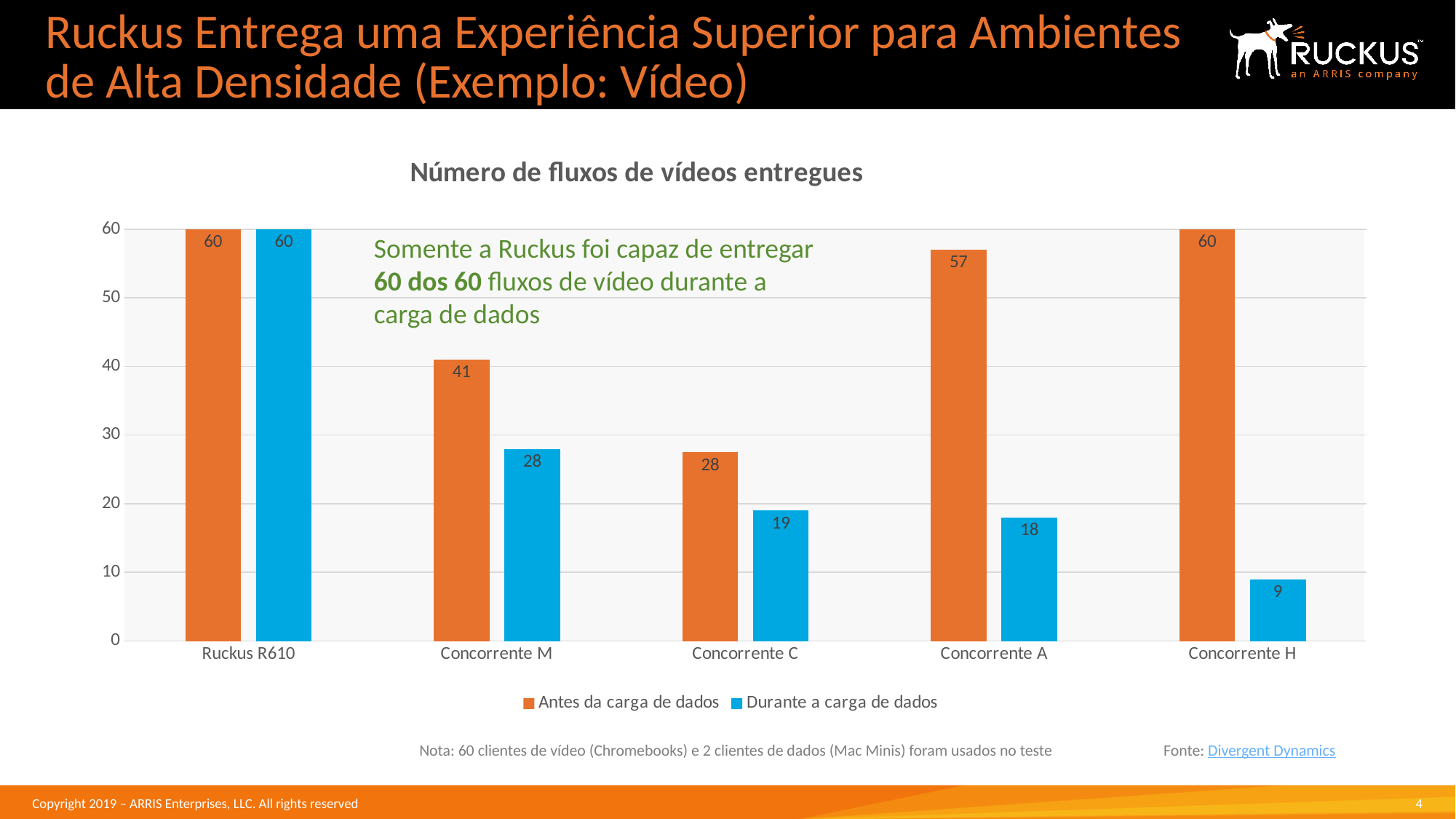
What is the title of the chart? Número de fluxos de vídeos entregues What is the value for Concorrente M in the 'Antes da carga de dados' series? 41 How many categories are shown on the x axis? 5 How many series does the legend list? 2 What is the difference between the 'Antes da carga de dados' and 'Durante a carga de dados' values for Concorrente H? 51 What is the value for Concorrente A in the 'Antes da carga de dados' series? 57 What is the difference between the 'Durante a carga de dados' values for Concorrente M and Concorrente C? 9 What kind of chart is shown on the slide? Bar chart What is the value for Concorrente H in the 'Durante a carga de dados' series? 9 Which category has the lowest value in the 'Durante a carga de dados' series? Concorrente H Which category has the lowest value in the 'Antes da carga de dados' series? Concorrente C Which is larger: the 'Durante a carga de dados' value for Concorrente C or for Concorrente A? Concorrente C